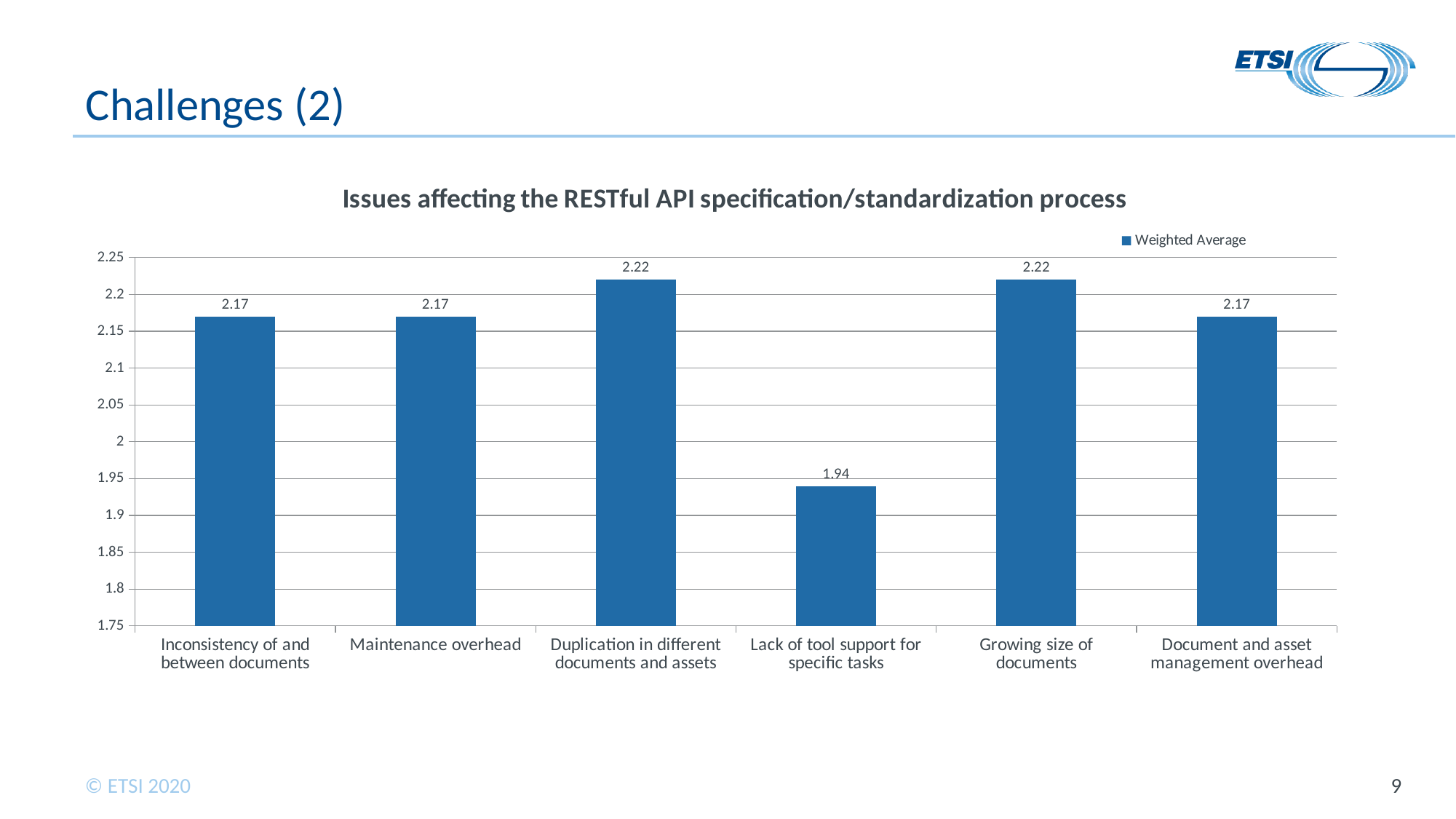
What is the weighted average for Lack of tool support for specific tasks? 1.94 What is the weighted average for Growing size of documents? 2.22 How many series does the legend list? 1 Which is larger: the weighted average for Inconsistency of and between documents or for Lack of tool support for specific tasks? Inconsistency of and between documents What is the difference between the weighted average for Growing size of documents and that for Document and asset management overhead? 0.05 What is the weighted average for Maintenance overhead? 2.17 How many categories are shown on the chart? 6 Is the value for Lack of tool support for specific tasks greater or less than 2? less What is the difference between the weighted average for Duplication in different documents and assets and that for Lack of tool support for specific tasks? 0.28 Which category has the lowest weighted average? Lack of tool support for specific tasks What is the title of the chart? Issues affecting the RESTful API specification/standardization process What kind of chart is shown on the slide? Bar chart